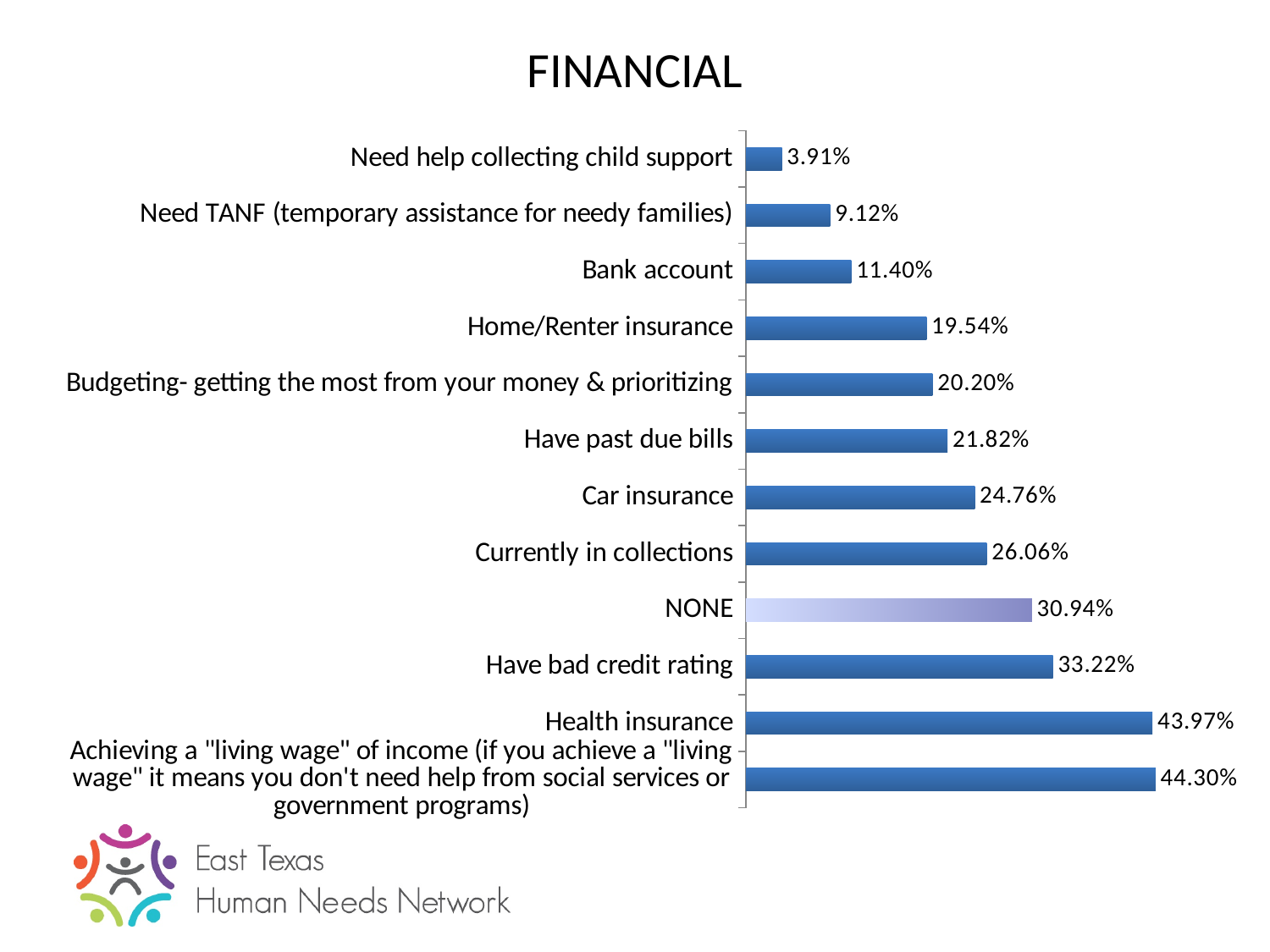
What is the value for Need TANF (temporary assistance for needy families)? 9.12% What is the title of the chart? FINANCIAL What is the difference between Car insurance and Bank account? 13.36% Which category has the highest value? Achieving a "living wage" of income What is the value for Have bad credit rating? 33.22% Which bar is shown in a different colour from the others? NONE What is the value for NONE? 30.94% Which is larger, Currently in collections or Have past due bills? Currently in collections What kind of chart is this? Bar chart How many categories are shown in the chart? 12 What is the value for Health insurance? 43.97% Which category has the lowest value? Need help collecting child support